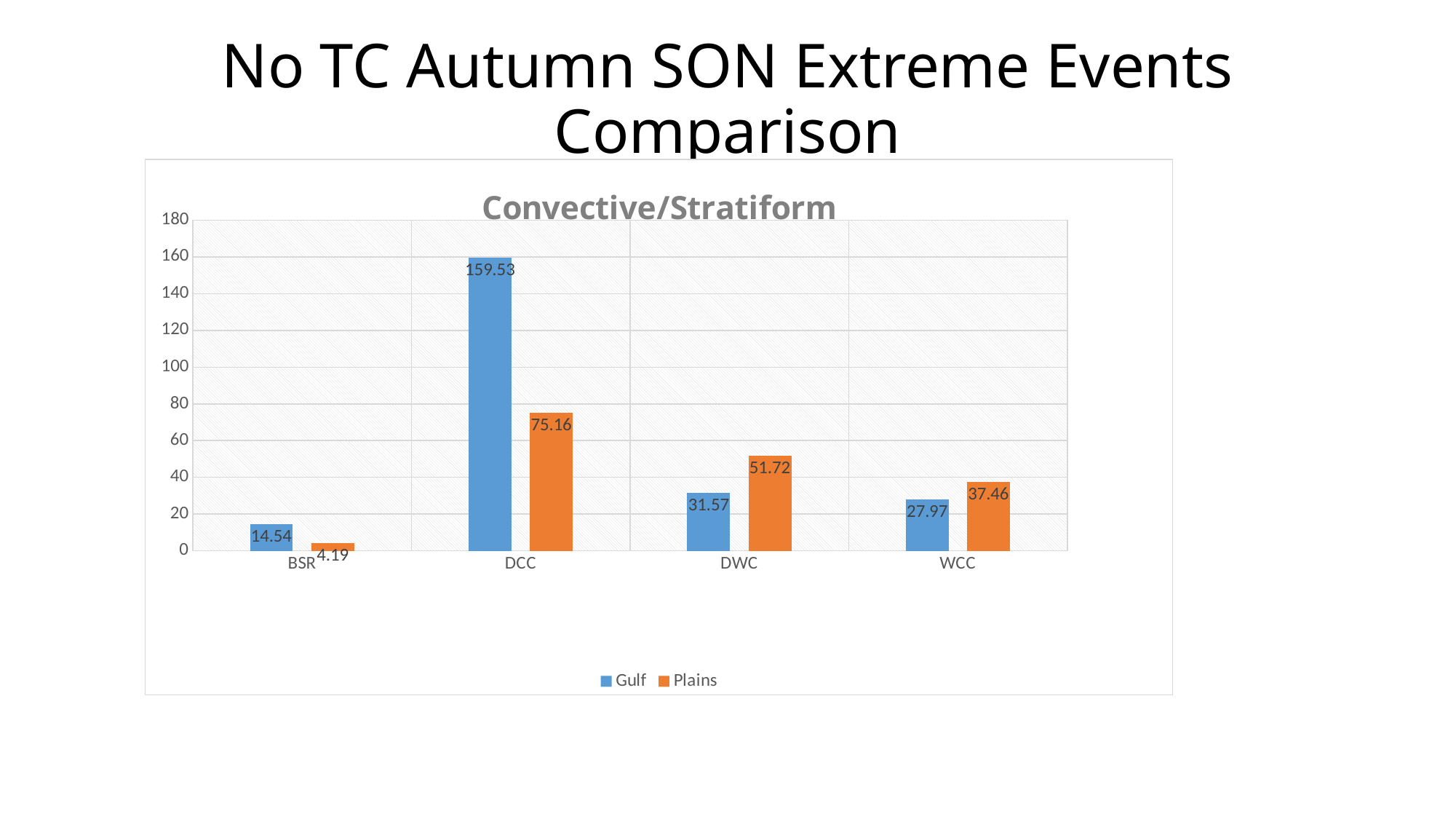
Which category has the lowest Plains value? BSR What is the title of the chart? Convective/Stratiform For DWC, which is larger, the Gulf value or the Plains value? Plains What is the Plains value for BSR? 4.19 What kind of chart is shown? Bar chart How many categories are shown on the x axis? 4 What is the Gulf value for WCC? 27.97 What is the Plains value for DWC? 51.72 What is the difference between the Gulf and Plains values for DCC? 84.37 How many series does the legend list? 2 Which category has the highest Gulf value? DCC What is the Gulf value for DCC? 159.53